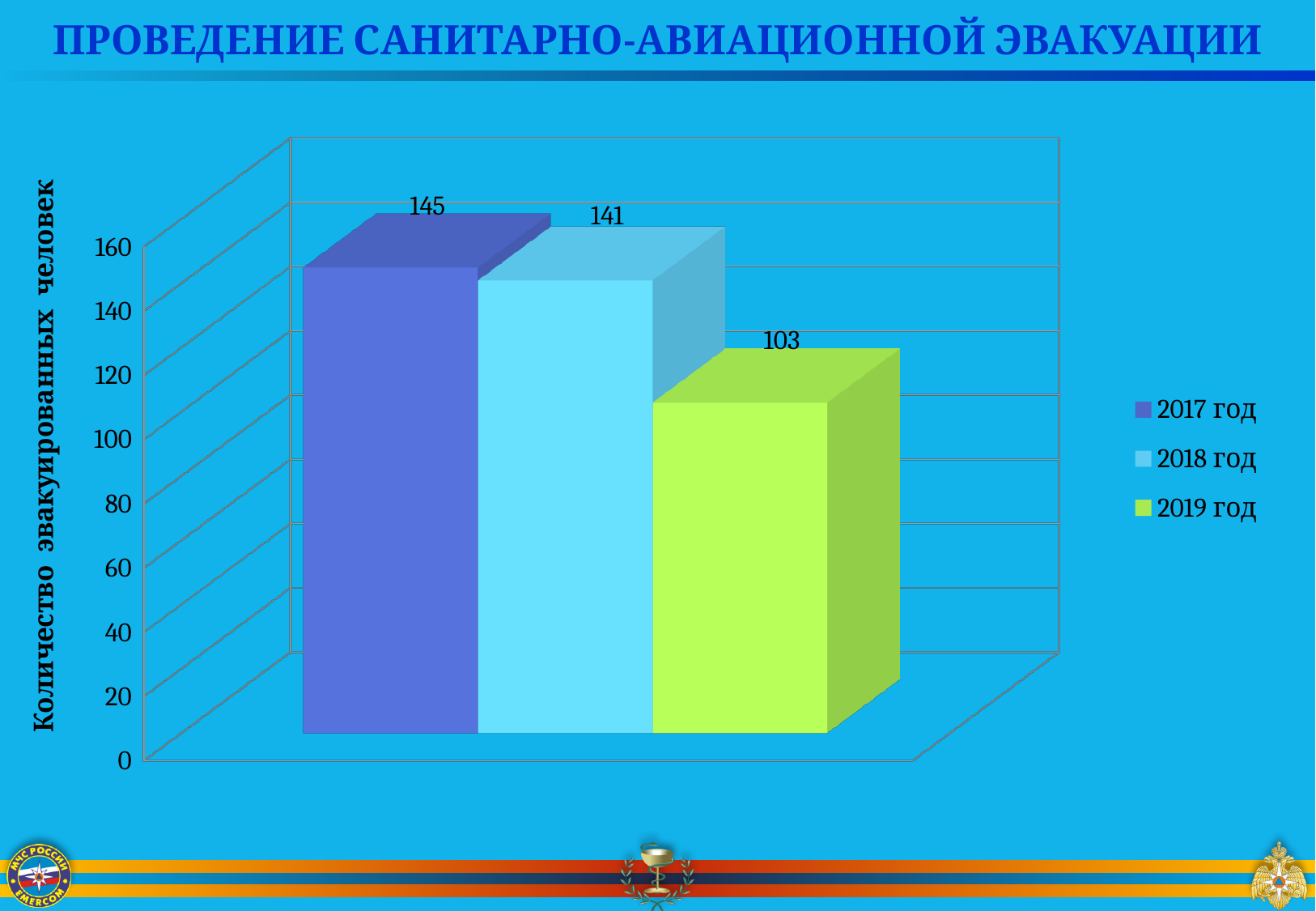
Which is larger, the value for 2018 год or the value for 2019 год? 2018 год What is the label of the vertical axis? Количество эвакуированных человек What is the difference between the values for 2017 год and 2018 год? 4 What is the difference between the values for 2017 год and 2019 год? 42 What is the value for 2019 год? 103 Which year has the lowest number of evacuated people? 2019 год Which year has the highest number of evacuated people? 2017 год What is the value for 2017 год? 145 What kind of chart is shown on the slide? bar chart What is the value for 2018 год? 141 Is the value for 2019 год greater or less than 120? less How many series does the legend list? 3